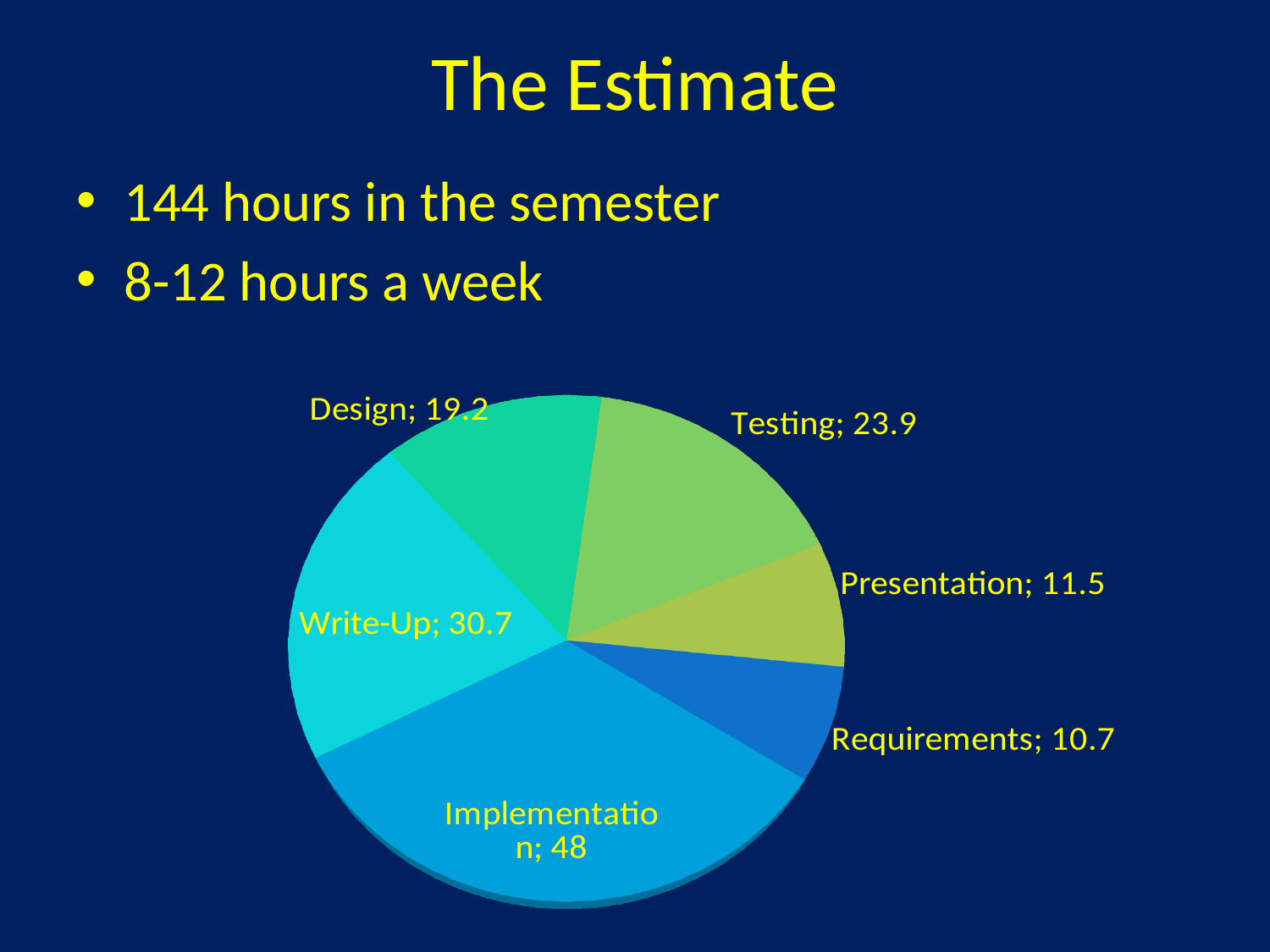
What is the total of all the slice values in the pie chart? 144 What value is shown for the Requirements slice of the pie chart? 10.7 What value is shown for the Testing slice of the pie chart? 23.9 What type of chart is shown on the slide? Pie chart What is the difference between the Testing and Design values in the pie chart? 4.7 Which is larger in the pie chart, Presentation or Requirements? Presentation Which slice of the pie chart has the smallest value? Requirements What value is shown for the Implementation slice of the pie chart? 48 What is the difference between the Implementation and Write-Up values in the pie chart? 17.3 How many slices does the pie chart have? 6 What value is shown for the Write-Up slice of the pie chart? 30.7 Which slice of the pie chart has the largest value? Implementation